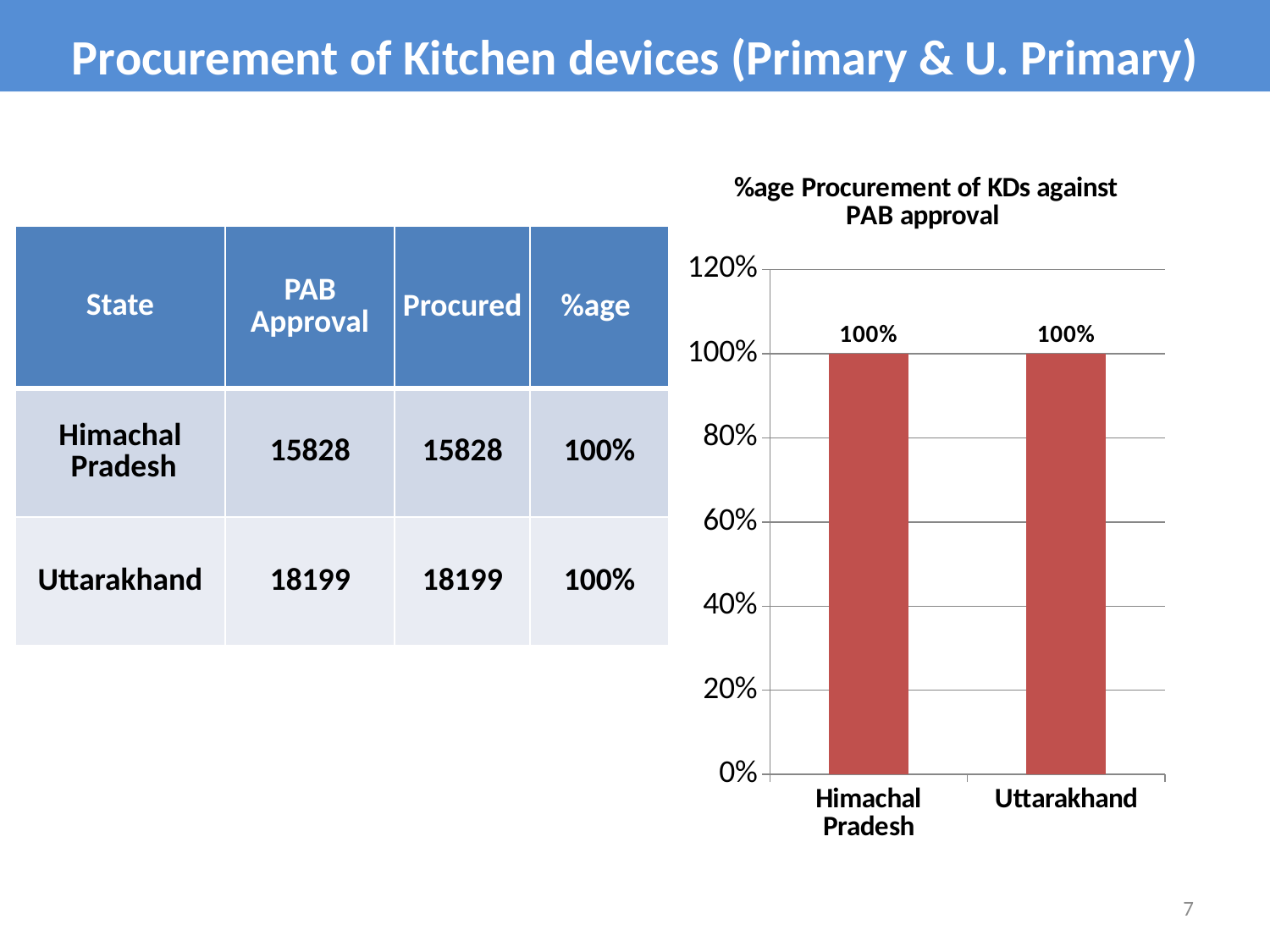
Is the value for Himachal Pradesh greater or less than 120%? less What is the highest value shown on the chart's vertical axis? 120% What is the value for Himachal Pradesh in the chart? 100% How many categories are plotted in the chart? 2 Do the values in the chart rise, fall, or stay the same from Himachal Pradesh to Uttarakhand? Stay the same What is the difference between the values for Himachal Pradesh and Uttarakhand in the chart? 0% What kind of chart is shown on the slide? Bar chart What is the title of the chart? %age Procurement of KDs against PAB approval Is the value for Uttarakhand greater or less than 80%? greater What is the value for Uttarakhand in the chart? 100%